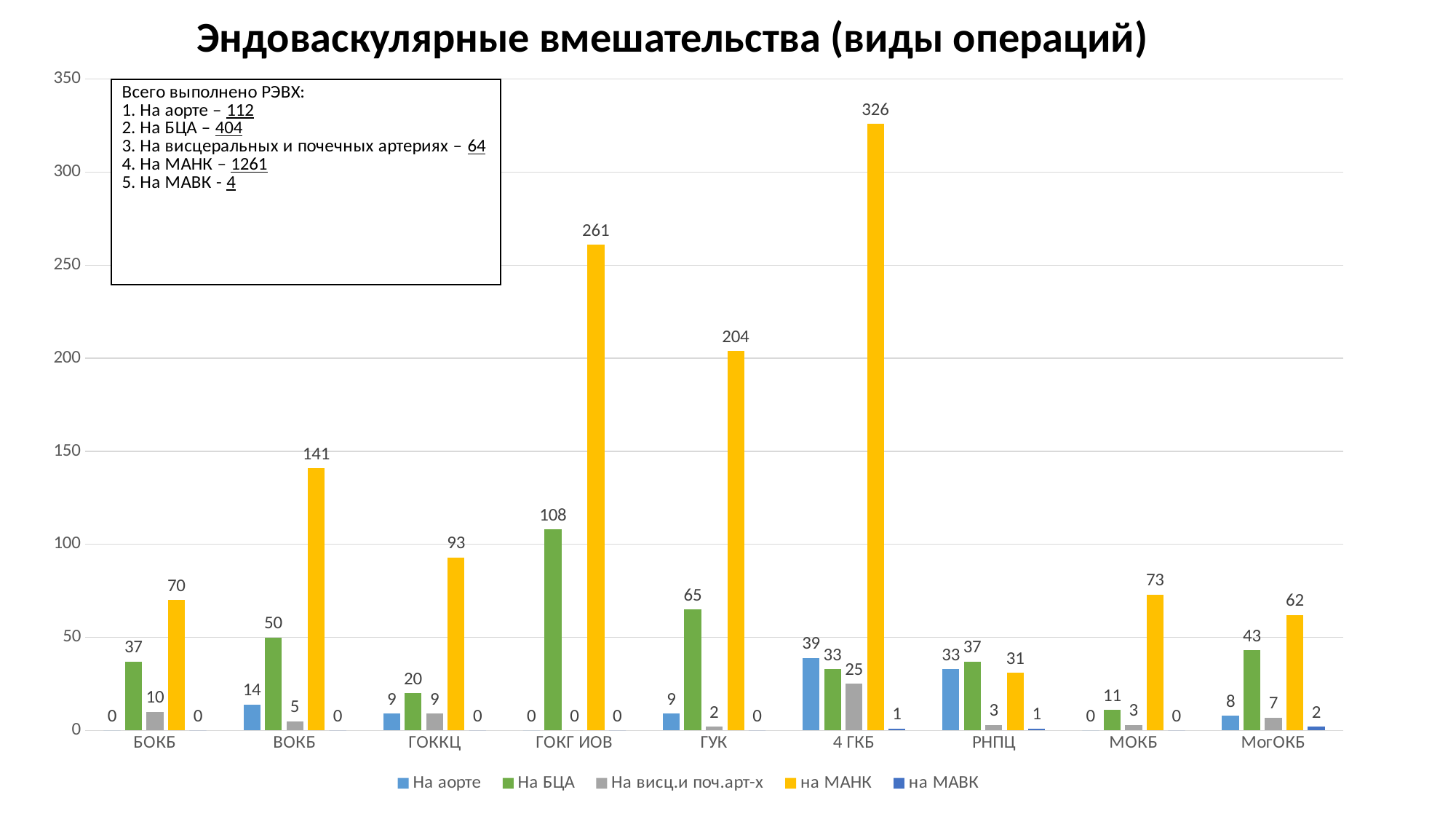
What is the value for На висц.и поч.арт-х at 4 ГКБ? 25 What is the value for На БЦА at ГОКГ ИОВ? 108 Which category has the highest value for на МАНК? 4 ГКБ What is the value for на МАНК at 4 ГКБ? 326 Which category has the lowest value for на МАНК? РНПЦ What is the title of the chart? Эндоваскулярные вмешательства (виды операций) What is the difference between the на МАНК values at ГОКГ ИОВ and ГУК? 57 How many categories are shown on the x axis? 9 Which is larger: На БЦА at ГУК or На БЦА at ВОКБ? На БЦА at ГУК What is the value for На аорте at РНПЦ? 33 How many series does the legend list? 5 What kind of chart is shown on the slide? bar chart